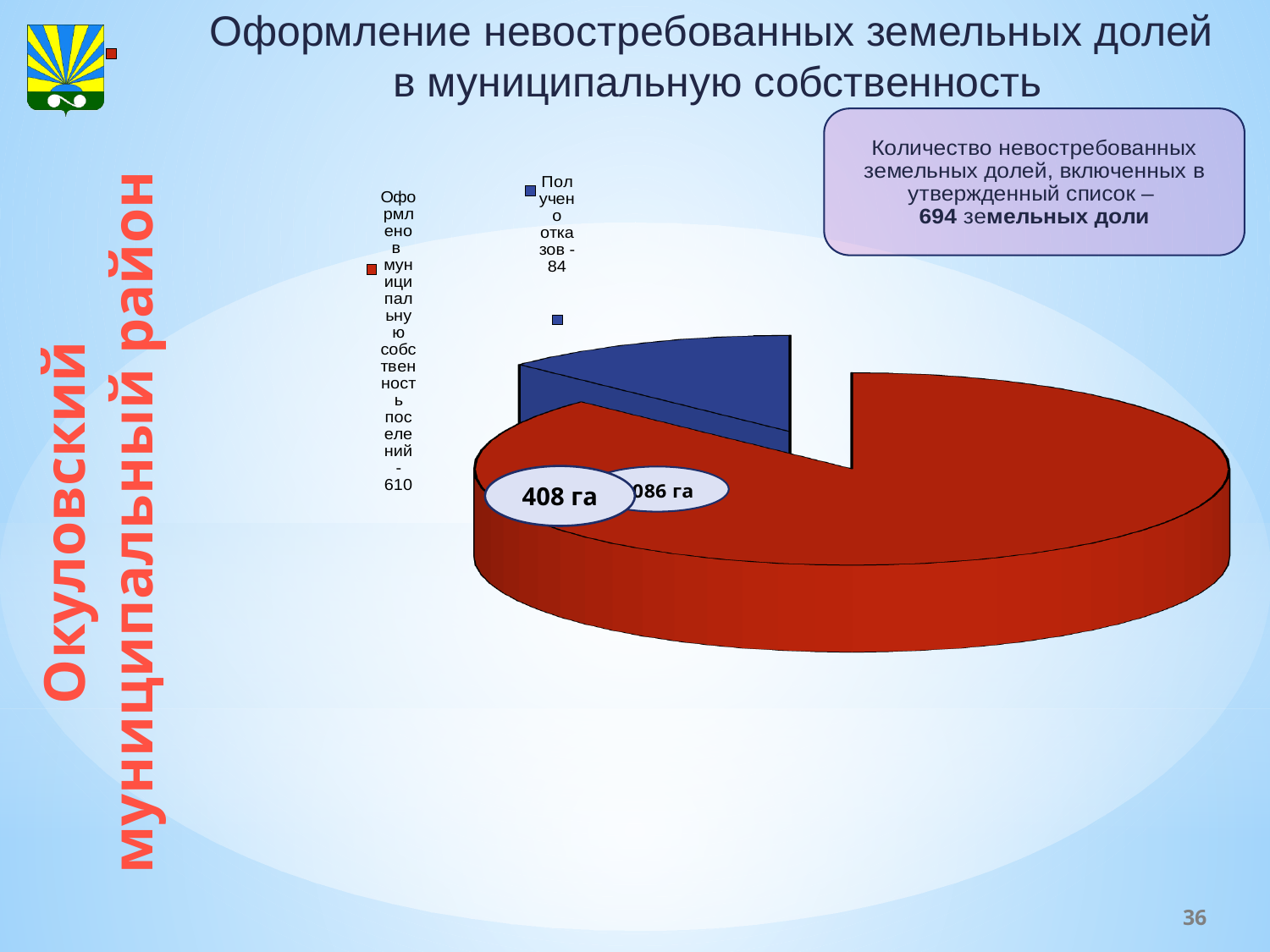
Which category has the larger slice of the pie? Оформлено в муниципальную собственность поселений How many slices does the pie chart have? 2 What colour is the slice for 'Оформлено в муниципальную собственность поселений'? red Which category has the smaller slice of the pie? Получено отказов According to the legend, how many refusals were received (Получено отказов)? 84 What is the difference between the number registered into municipal ownership (610) and the number of refusals (84)? 526 Which is larger: the number registered into municipal ownership (610) or the number of refusals (84)? Оформлено в муниципальную собственность поселений (610) According to the legend, how many land shares were registered into municipal ownership of settlements (Оформлено в муниципальную собственность поселений)? 610 What kind of chart is shown on the slide? pie chart What is the total number of unclaimed land shares included in the approved list, as stated on the slide? 694 What colour is the slice for 'Получено отказов'? blue How many entries does the chart legend list? 2